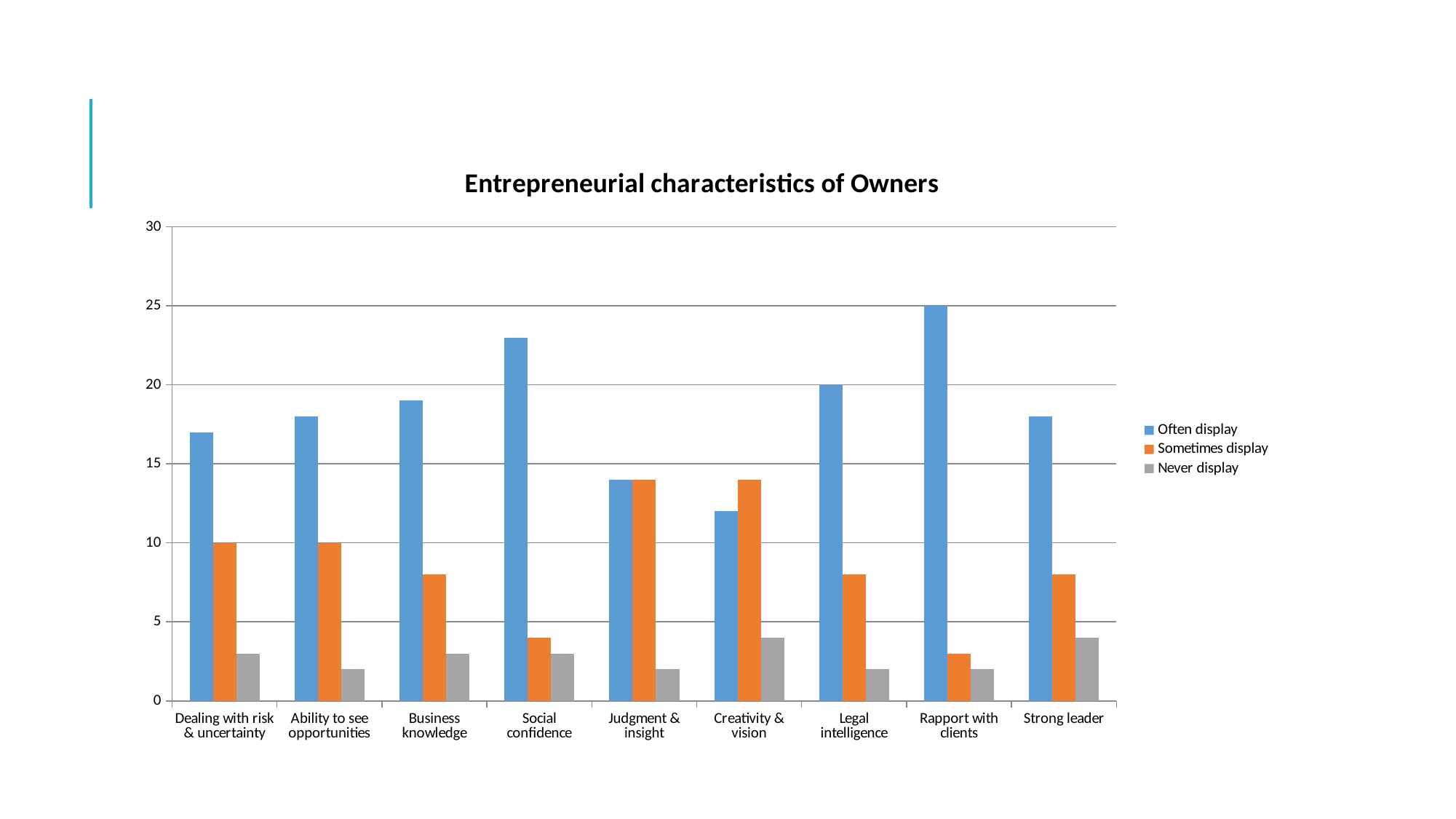
Which category has the lowest value for Often display? Creativity & vision How many series does the legend list? 3 Is the Often display value for Social confidence greater or less than 20? greater For Creativity & vision, which is larger: Often display or Sometimes display? Sometimes display What is the title of the chart? Entrepreneurial characteristics of Owners How many categories are shown on the x axis? 9 What is the Often display value for Rapport with clients? 25 Is the Sometimes display value for Rapport with clients greater or less than 5? less What kind of chart is shown on the slide? bar chart What is the Sometimes display value for Dealing with risk & uncertainty? 10 Which category has the highest value for Often display? Rapport with clients What is the Often display value for Legal intelligence? 20